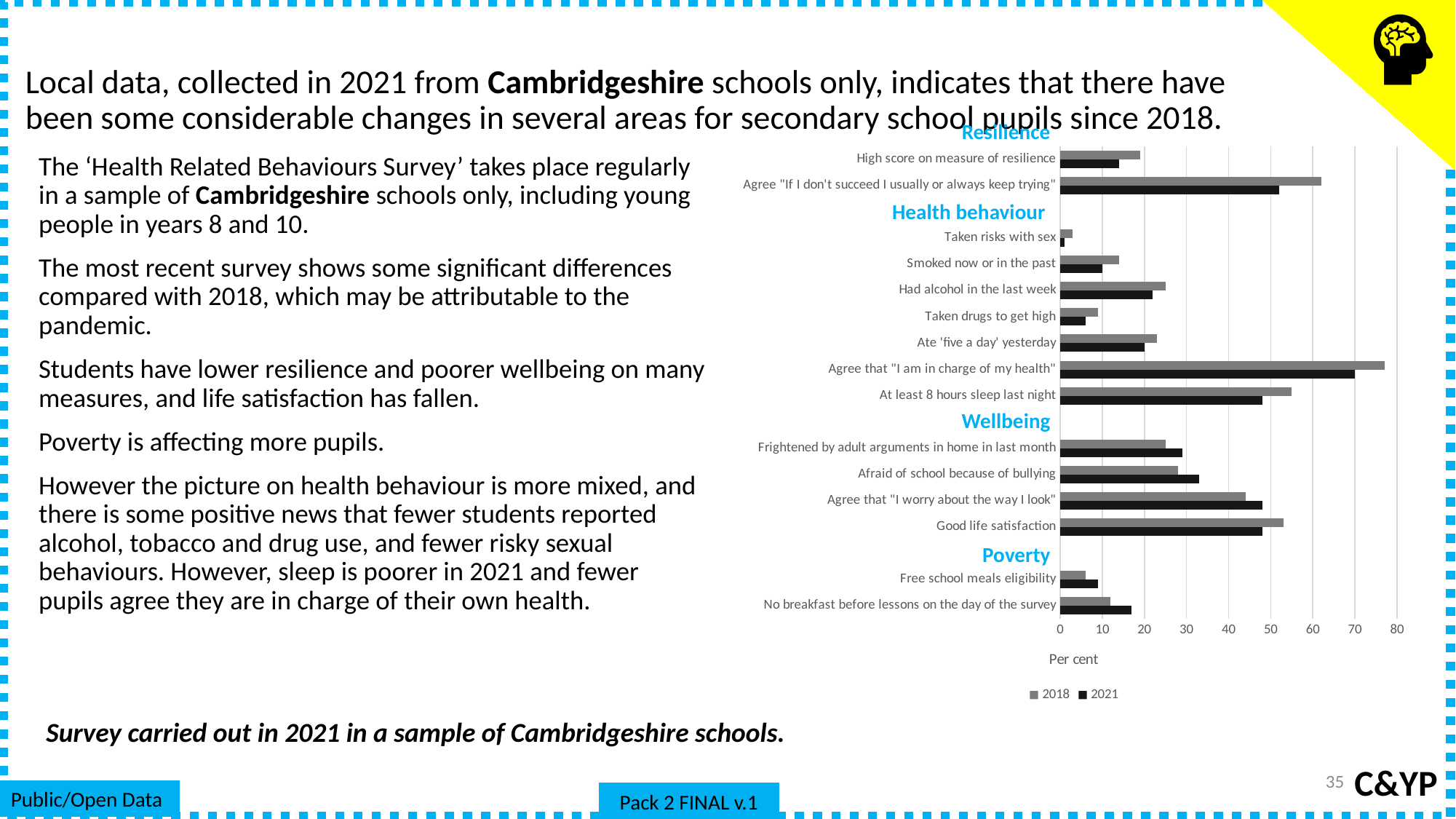
What kind of chart is shown on the slide? Bar chart How many series does the chart's legend list? 2 How many survey measures (categories) are plotted in the chart? 15 Is the 2021 value for 'At least 8 hours sleep last night' greater or less than 50? less Is the 2018 value for 'Good life satisfaction' greater or less than 50? greater For 'No breakfast before lessons on the day of the survey', which year has the larger value, 2018 or 2021? 2021 Which measure has the lowest value for 2021? Taken risks with sex Is the 2018 value for 'Agree that "I am in charge of my health"' greater or less than 70? greater Which measure has the highest value for 2018? Agree that "I am in charge of my health" Which two years are listed in the chart's legend? 2018 and 2021 What is the label on the chart's horizontal axis? Per cent For 'Agree "If I don't succeed I usually or always keep trying"', which year has the larger value, 2018 or 2021? 2018